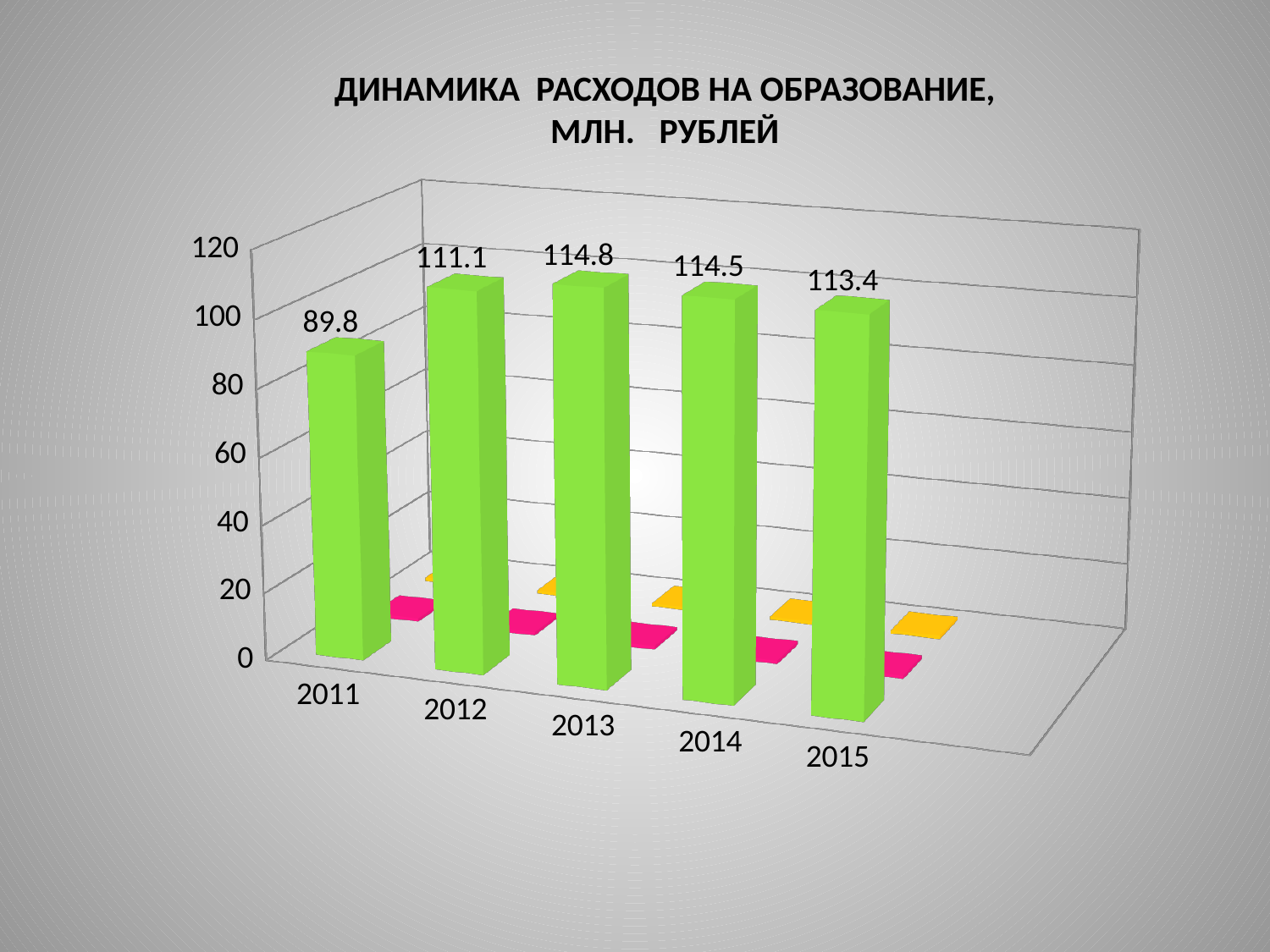
Which is larger, the value for 2014 or the value for 2011? 2014 What is the difference between the values for 2013 and 2015? 1.4 What is the difference between the values for 2012 and 2011? 21.3 What is the value for 2011? 89.8 What is the value for 2012? 111.1 Which year has the lowest value? 2011 What kind of chart is shown on the slide? bar chart What is the title of the chart? ДИНАМИКА РАСХОДОВ НА ОБРАЗОВАНИЕ, МЛН. РУБЛЕЙ Which year has the highest value? 2013 What is the value for 2015? 113.4 What is the value for 2013? 114.8 How many years are shown on the x axis? 5